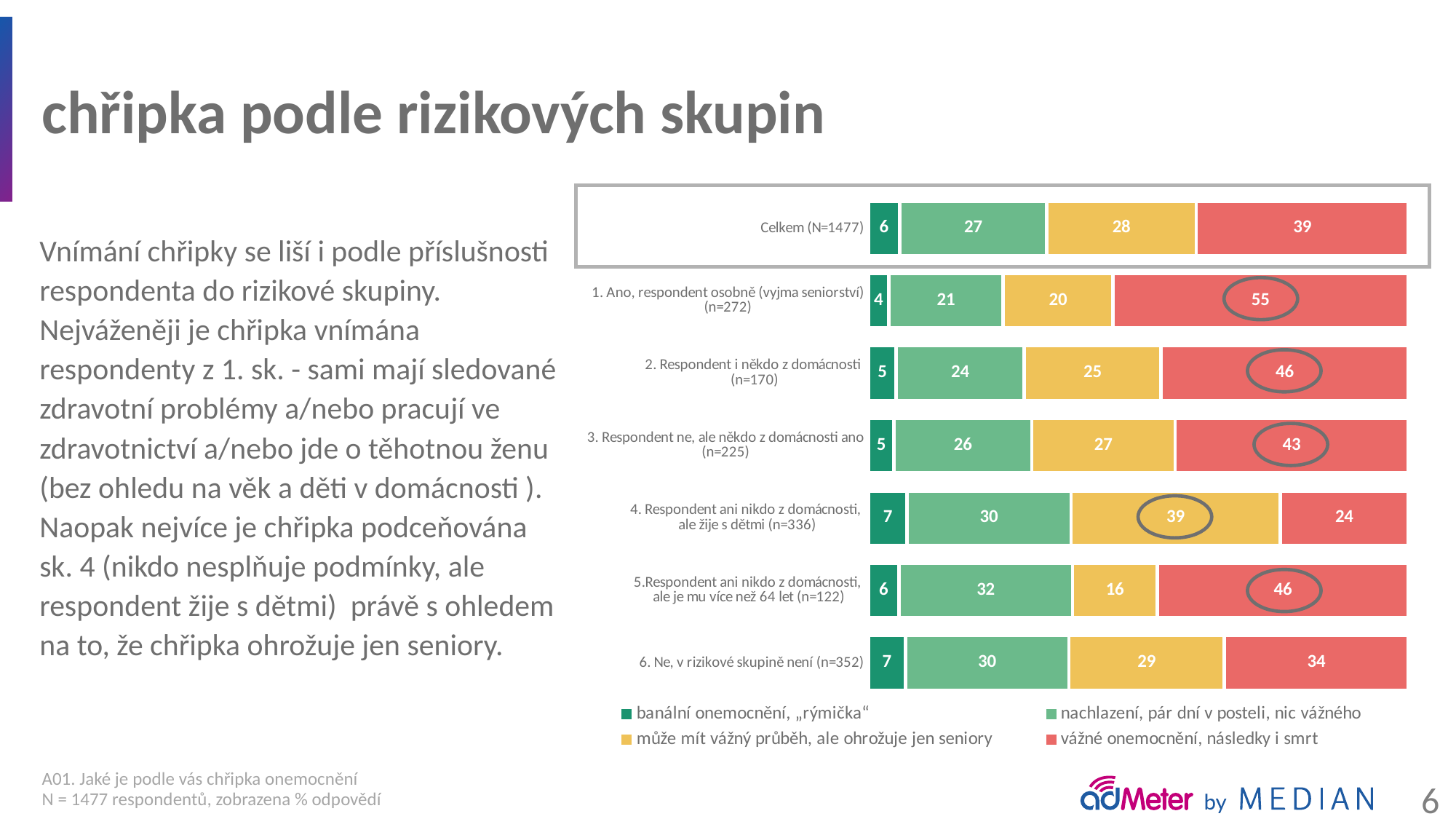
How many categories (rows) are plotted in the chart? 7 What is the difference between the 'vážné onemocnění, následky i smrt' values for '1. Ano, respondent osobně (vyjma seniorství) (n=272)' and 'Celkem (N=1477)'? 16 Which category has the highest value for 'vážné onemocnění, následky i smrt'? 1. Ano, respondent osobně (vyjma seniorství) (n=272) Which category has the lowest value for 'vážné onemocnění, následky i smrt'? 4. Respondent ani nikdo z domácnosti, ale žije s dětmi (n=336) What type of chart is shown on the slide? stacked bar chart What is the value of 'vážné onemocnění, následky i smrt' for 'Celkem (N=1477)'? 39 Which colour represents the series 'banální onemocnění, „rýmička“' in the chart? dark green How many series does the legend list? 4 What is the value of 'může mít vážný průběh, ale ohrožuje jen seniory' for '4. Respondent ani nikdo z domácnosti, ale žije s dětmi (n=336)'? 39 What is the value of 'nachlazení, pár dní v posteli, nic vážného' for '5.Respondent ani nikdo z domácnosti, ale je mu více než 64 let (n=122)'? 32 What is the total of the stacked bar for '6. Ne, v rizikové skupině není (n=352)'? 100 Which is larger: the 'může mít vážný průběh, ale ohrožuje jen seniory' value for '2. Respondent i někdo z domácnosti (n=170)' or for '5.Respondent ani nikdo z domácnosti, ale je mu více než 64 let (n=122)'? 2. Respondent i někdo z domácnosti (n=170)